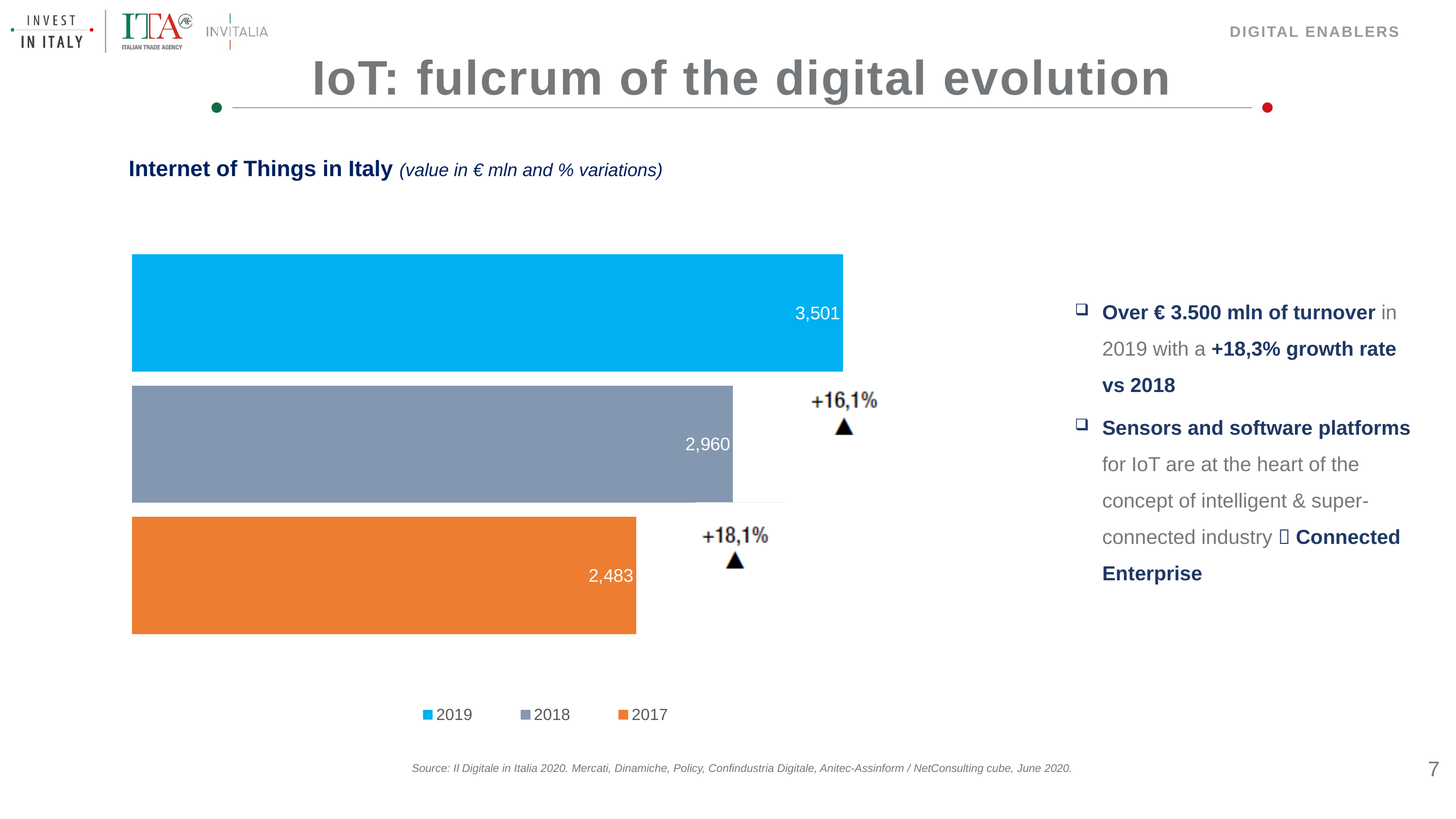
What is the difference between the 2018 and 2017 values in the Internet of Things in Italy chart? 477 How many series does the legend of the Internet of Things in Italy chart list? 3 Which year has the highest value in the Internet of Things in Italy chart? 2019 What kind of chart is the Internet of Things in Italy chart? Bar chart Which is larger in the Internet of Things in Italy chart, the value for 2018 or the value for 2017? 2018 What colour is the bar for 2017 in the Internet of Things in Italy chart? Orange What is the value for 2017 in the Internet of Things in Italy chart? 2,483 What is the value for 2019 in the Internet of Things in Italy chart? 3,501 What is the value for 2018 in the Internet of Things in Italy chart? 2,960 Which year has the lowest value in the Internet of Things in Italy chart? 2017 Do the values in the Internet of Things in Italy chart rise or fall from 2017 to 2019? Rise What is the difference between the 2019 and 2018 values in the Internet of Things in Italy chart? 541